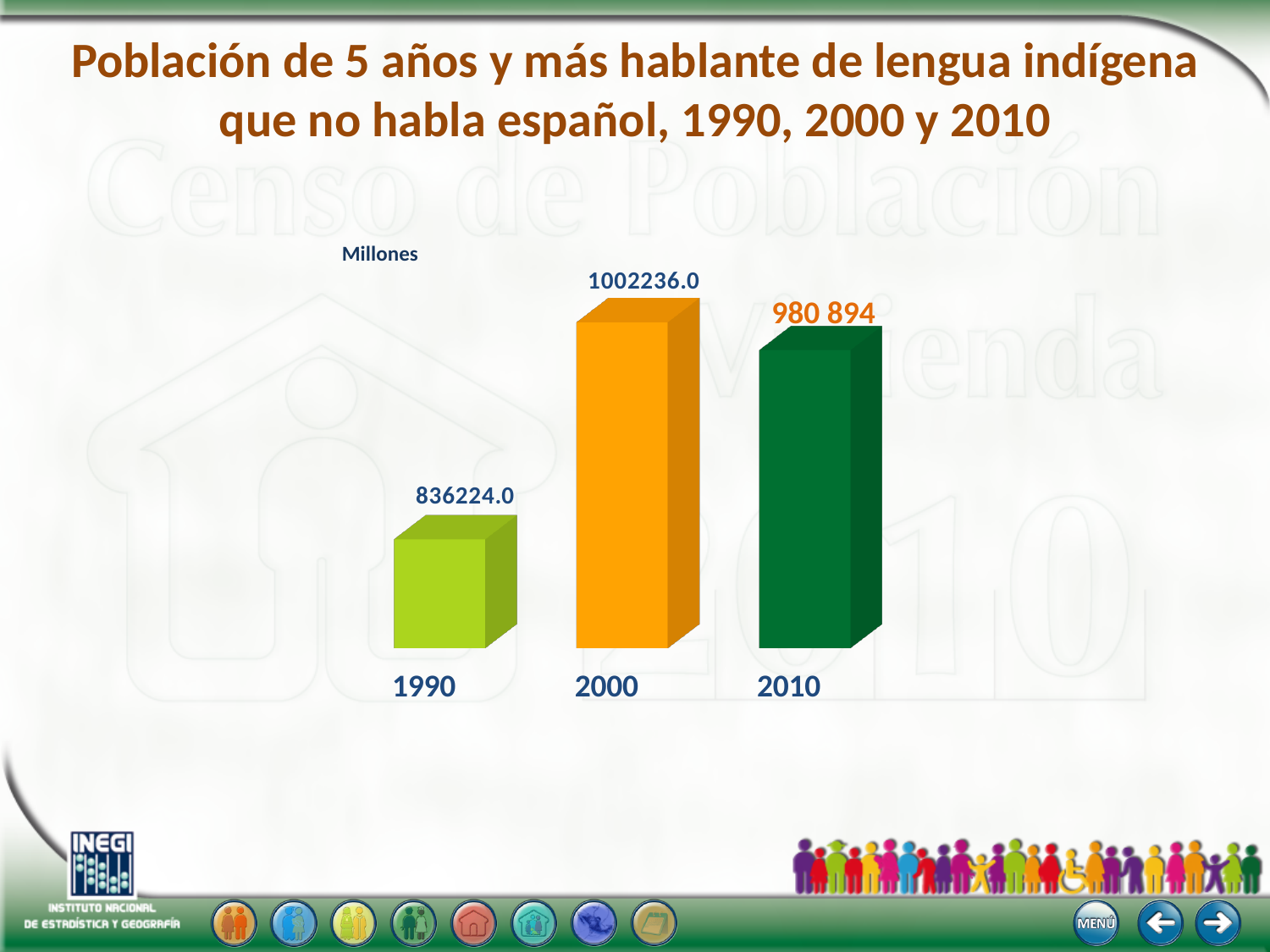
How many years are shown on the chart? 3 What is the value shown for 2000? 1002236.0 What is the difference between the values for 2000 and 2010? 21342 What is the value shown for 1990? 836224.0 Which year has the highest value? 2000 What is the difference between the values for 2000 and 1990? 166012.0 Does the value rise or fall from 1990 to 2000? Rise What kind of chart is shown on the slide? Bar chart Which is larger, the value for 1990 or the value for 2010? 2010 What is the value shown for 2010? 980 894 Which year has the lowest value? 1990 What unit label is shown above the chart? Millones